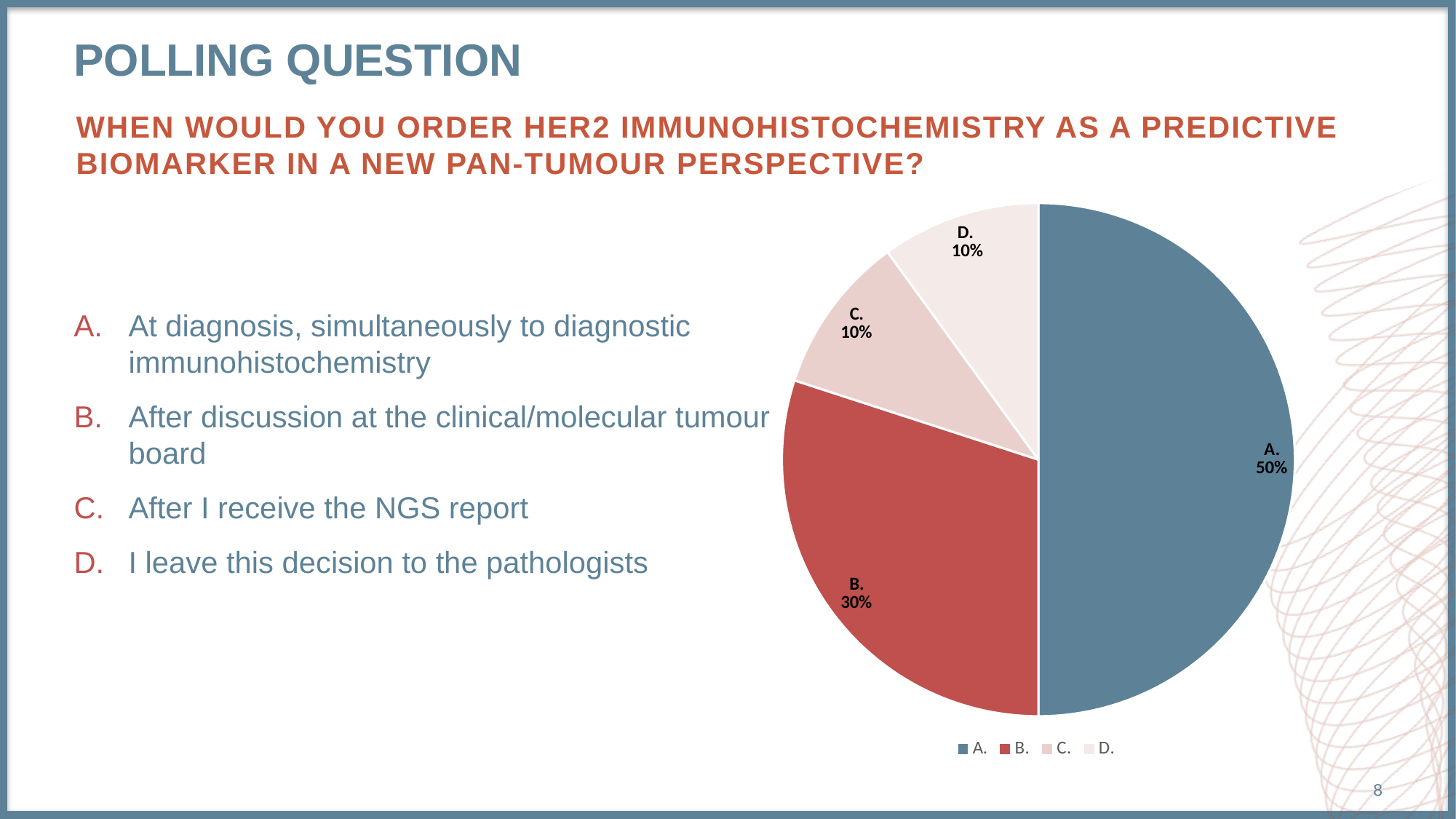
What share of the pie does option A. have? 50% How many slices does the pie chart have? 4 Which is larger, the slice for option B. or the slice for option C.? B. What is the difference in percentage points between option A. and option B.? 20 What colour is the slice for option B.? red Which option has the largest slice of the pie? A. What is the combined share of options C. and D.? 20% What share of the pie does option D. have? 10% How many entries does the legend list? 4 What share of the pie does option C. have? 10% What kind of chart is shown on the slide? pie chart What share of the pie does option B. have? 30%